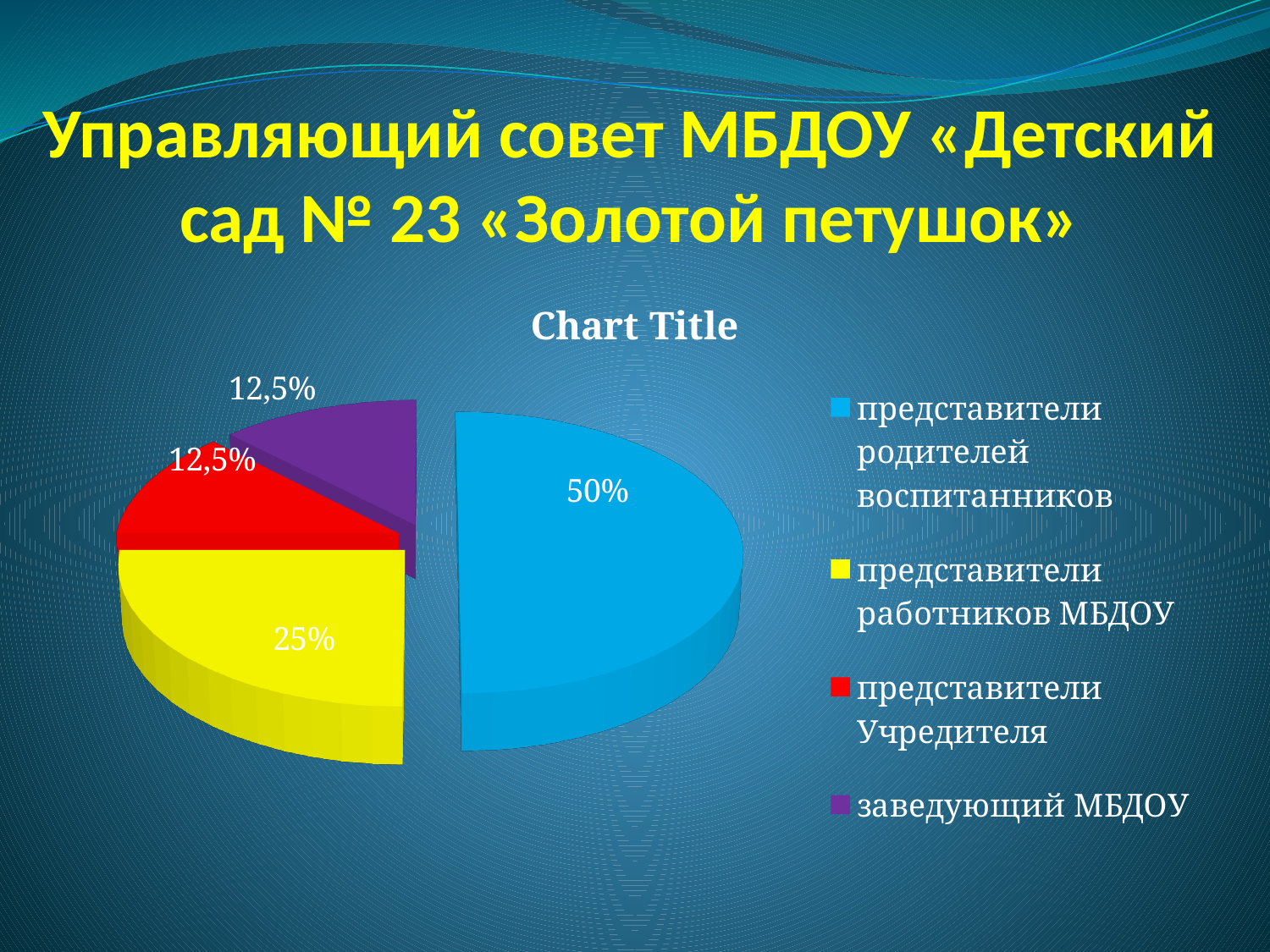
What share of the pie is labelled for представители родителей воспитанников? 50% What colour is the slice for представители Учредителя? red What share of the pie is labelled for представители работников МБДОУ? 25% Which category has the largest slice of the pie? представители родителей воспитанников What share of the pie is labelled for представители Учредителя? 12,5% What kind of chart is shown on the slide? pie chart What is the difference between the share for представители родителей воспитанников and the share for представители работников МБДОУ? 25% What share of the pie is labelled for заведующий МБДОУ? 12,5% What is the title shown above the pie chart? Chart Title Which slice is larger: представители родителей воспитанников or представители работников МБДОУ? представители родителей воспитанников How many categories does the legend list? 4 What is the difference between the share for представители работников МБДОУ and the share for заведующий МБДОУ? 12,5%